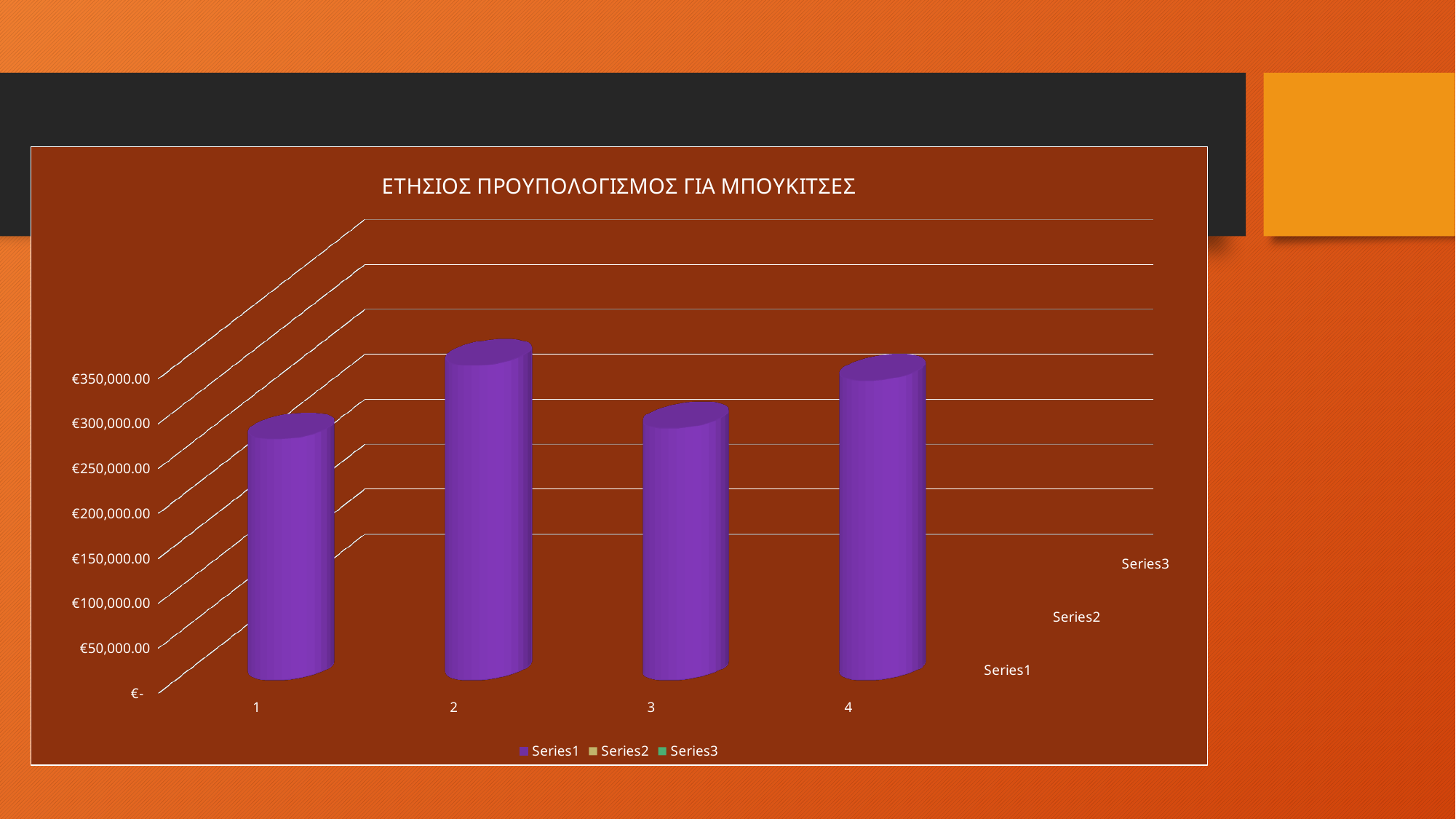
What kind of chart is shown on the slide? bar chart Which category has the highest bar in the chart? 2 Is the value for category 3 greater or less than €350,000.00? less Which is larger, the value for category 2 or the value for category 1? category 2 Which is larger, the value for category 4 or the value for category 3? category 4 Is the value for category 4 greater or less than €300,000.00? greater How many series does the chart legend list? 3 How many categories are shown on the x axis of the chart? 4 What colour are the bars for Series1 in the chart? purple What is the title of the chart? ΕΤΗΣΙΟΣ ΠΡΟΥΠΟΛΟΓΙΣΜΟΣ ΓΙΑ ΜΠΟΥΚΙΤΣΕΣ Is the value for category 2 greater or less than €300,000.00? greater